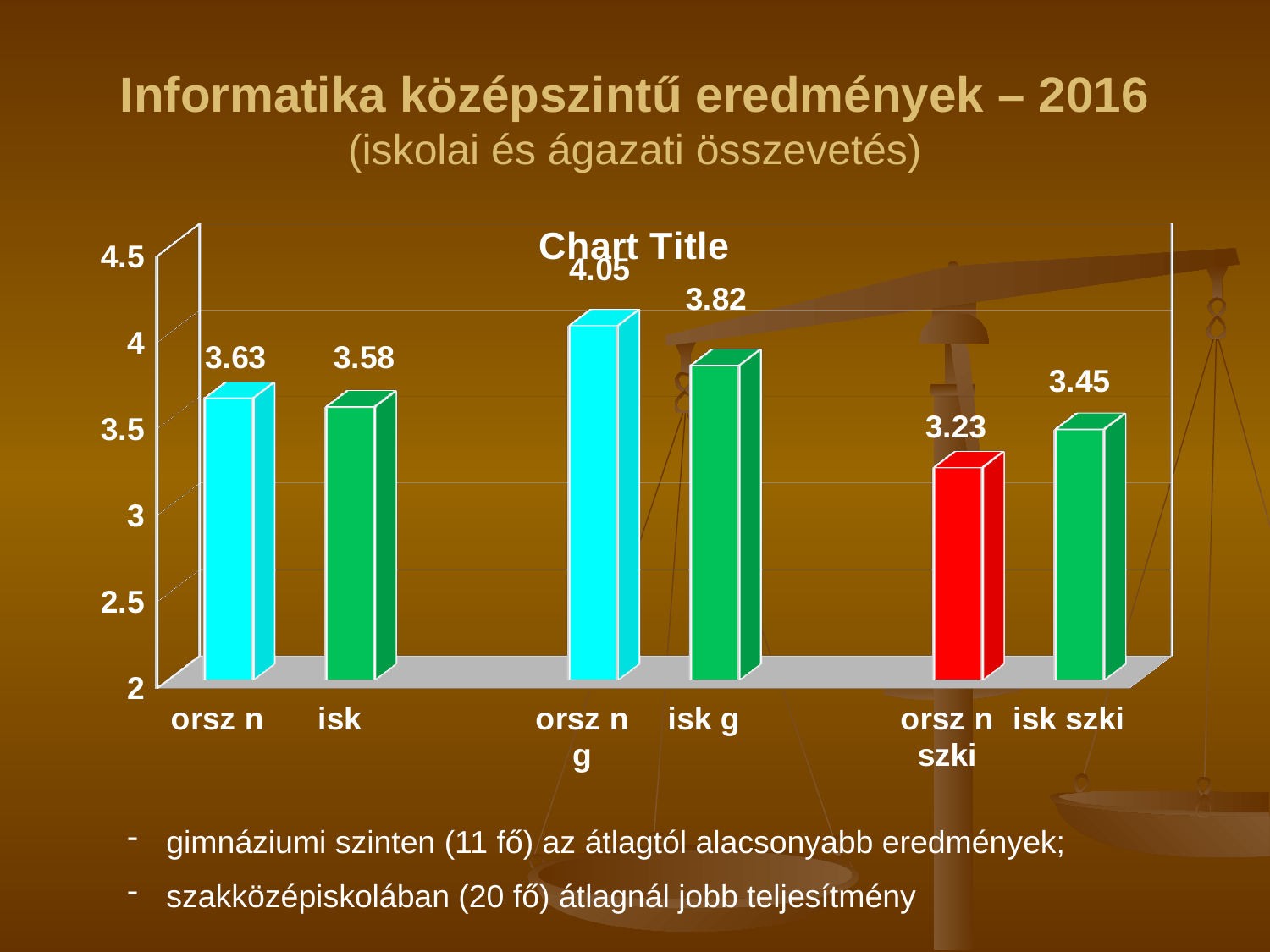
What is the value for "isk szki"? 3.45 Which is larger, the value for "isk" or the value for "isk szki"? isk What kind of chart is shown on the slide? bar chart Is the value for "orsz n g" greater or less than 4? greater What is the difference between the values for "isk szki" and "orsz n szki"? 0.22 What is the difference between the values for "orsz n g" and "isk g"? 0.23 How many bars are shown in the chart? 6 What is the value for "orsz n szki"? 3.23 What is the value for "orsz n"? 3.63 What is the value for "isk g"? 3.82 Which category has the lowest value? orsz n szki Which category has the highest value? orsz n g